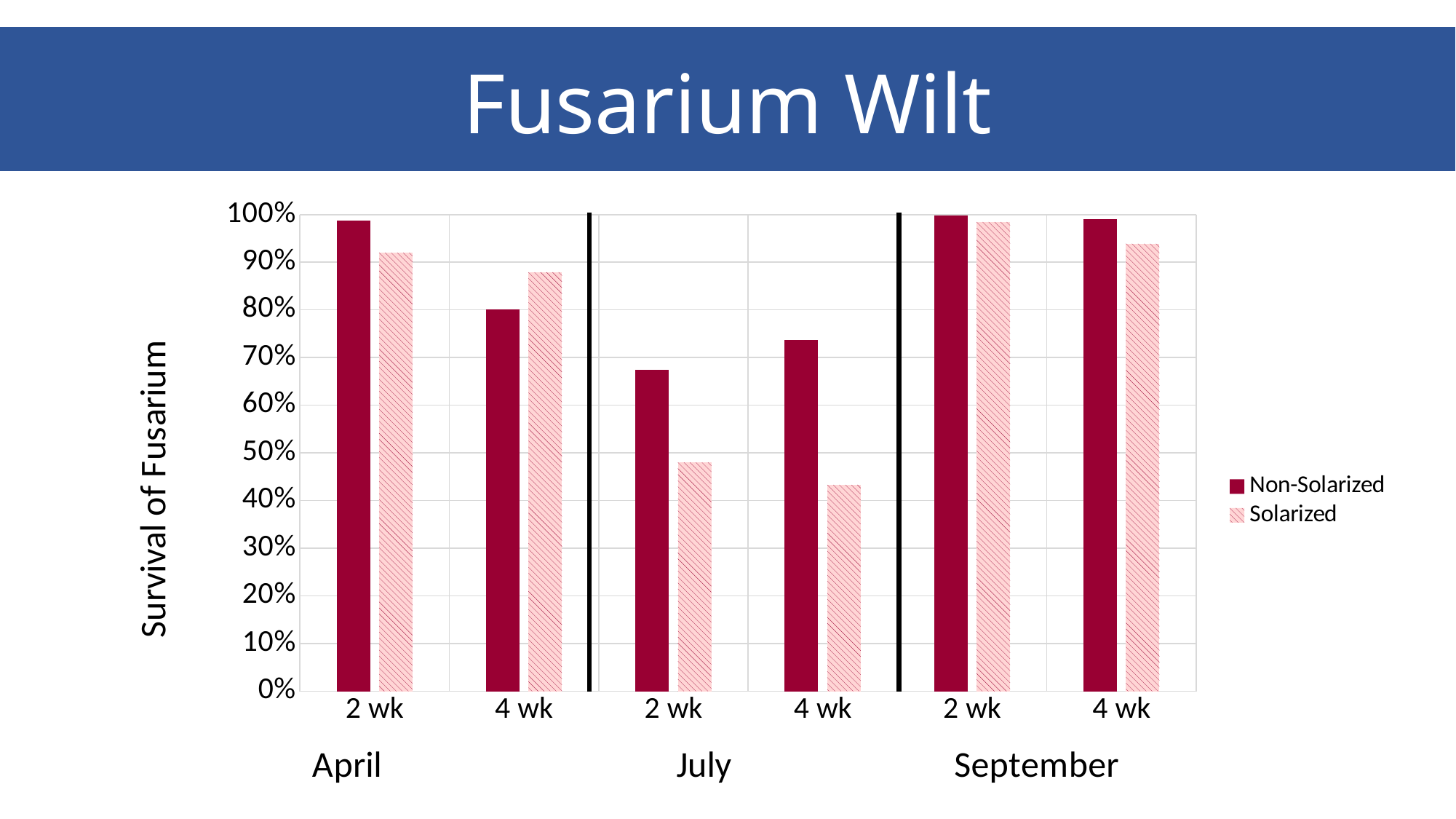
What is the title of the y axis? Survival of Fusarium Which month and time point has the lowest Solarized survival? July 4 wk Is the Solarized value for July 2 wk greater or less than 50%? less For April 4 wk, which is larger: Non-Solarized or Solarized? Solarized How many time-point categories (2 wk / 4 wk) are shown along the x axis in total? 6 How many series does the legend list? 2 Is the Solarized value for July 4 wk greater or less than 50%? less Is the Non-Solarized value for July 2 wk greater or less than 60%? greater What kind of chart is shown on the slide? bar chart For July 2 wk, which is larger: Non-Solarized or Solarized? Non-Solarized Which month and time point has the lowest Non-Solarized survival? July 2 wk